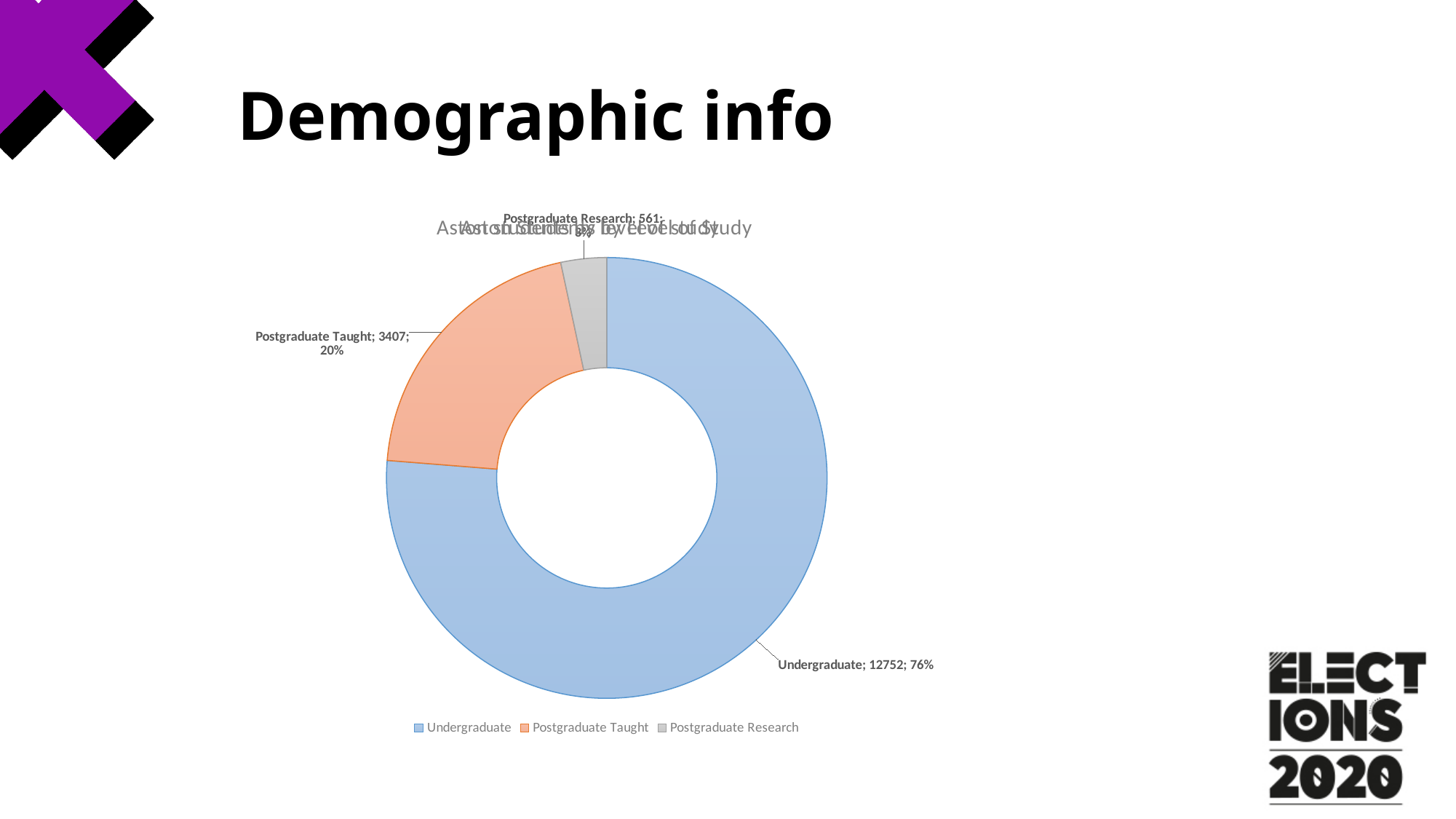
Which category has the smallest value? Postgraduate Research What is the value for Postgraduate Taught? 3407 Which category has the largest value? Undergraduate What share of the chart does Postgraduate Taught represent? 20% What is the value for Postgraduate Research? 561 Which category is shown in orange? Postgraduate Taught How many categories does the chart show? 3 Which is larger, Postgraduate Taught or Postgraduate Research? Postgraduate Taught What share of the chart does Undergraduate represent? 76% What is the value for Undergraduate? 12752 What kind of chart is shown on the slide? Doughnut (pie) chart What is the difference between the Undergraduate and Postgraduate Taught values? 9345